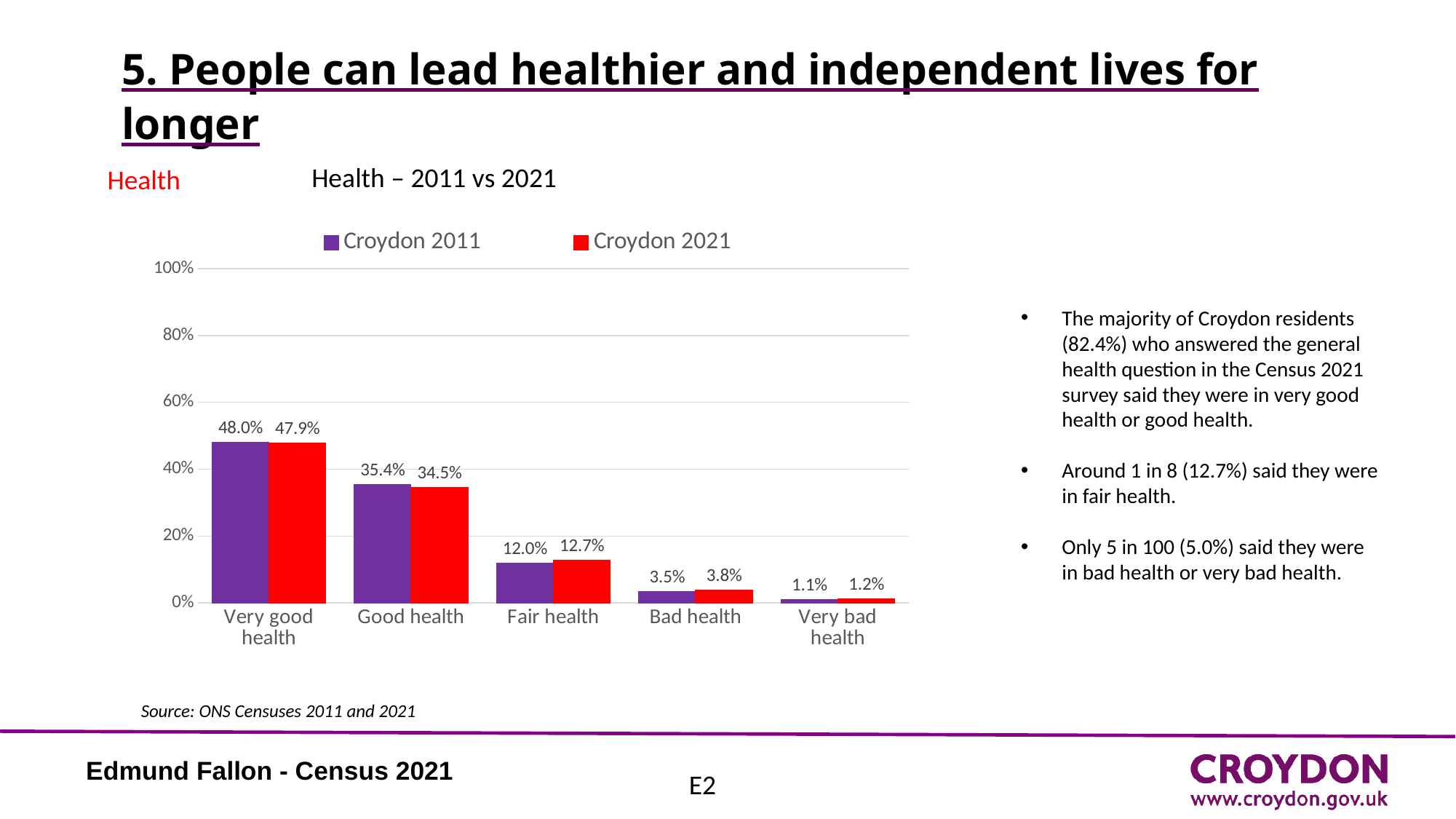
What kind of chart is shown on the slide? Bar chart How many health categories are shown on the x axis? 5 What is the title of the chart? Health – 2011 vs 2021 Which health category has the lowest value in the Croydon 2011 series? Very bad health What is the value for Fair health in the Croydon 2021 series? 12.7% Which health category has the highest value in the Croydon 2021 series? Very good health What is the value for Very bad health in the Croydon 2011 series? 1.1% Is the Croydon 2011 value for Very good health greater or less than 40%? greater How many series does the legend list? 2 What is the value for Good health in the Croydon 2011 series? 35.4% Which is larger for Bad health: the Croydon 2011 value or the Croydon 2021 value? Croydon 2021 What is the difference between the Croydon 2011 and Croydon 2021 values for Good health? 0.9%